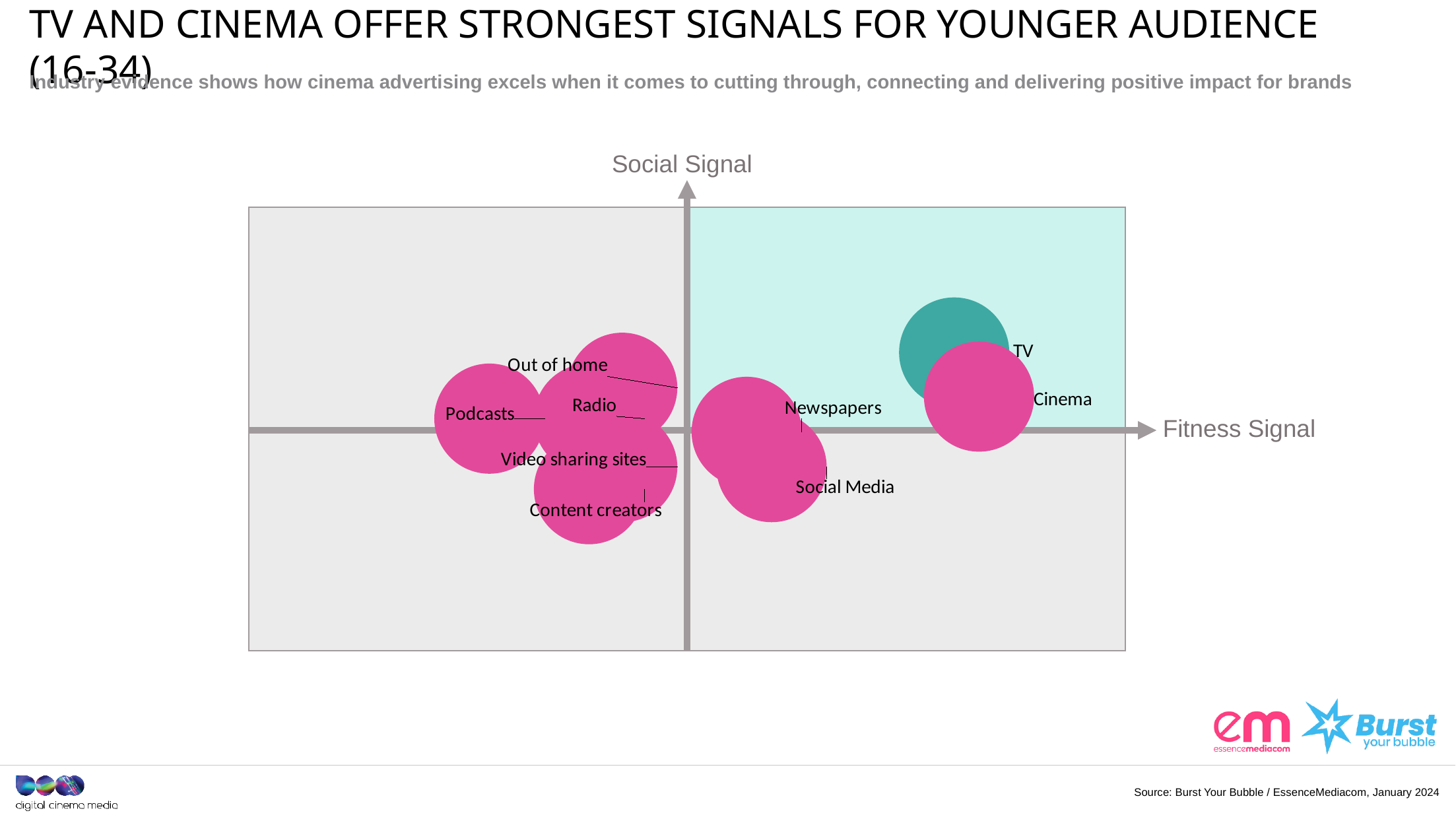
What is the label of the horizontal axis of the chart? Fitness Signal Which has the higher Social Signal, Out of home or Social Media? Out of home Which media channel has the lowest Social Signal on the chart? Content creators What kind of chart is shown on the slide? Bubble chart Which media channel is positioned furthest left on the Fitness Signal axis? Podcasts Which has the higher Social Signal, TV or Cinema? TV What is the label of the vertical axis of the chart? Social Signal How many media channels are plotted as bubbles on the chart? 9 Which media channel has the highest Social Signal on the chart? TV Which has the higher Fitness Signal, Podcasts or Newspapers? Newspapers